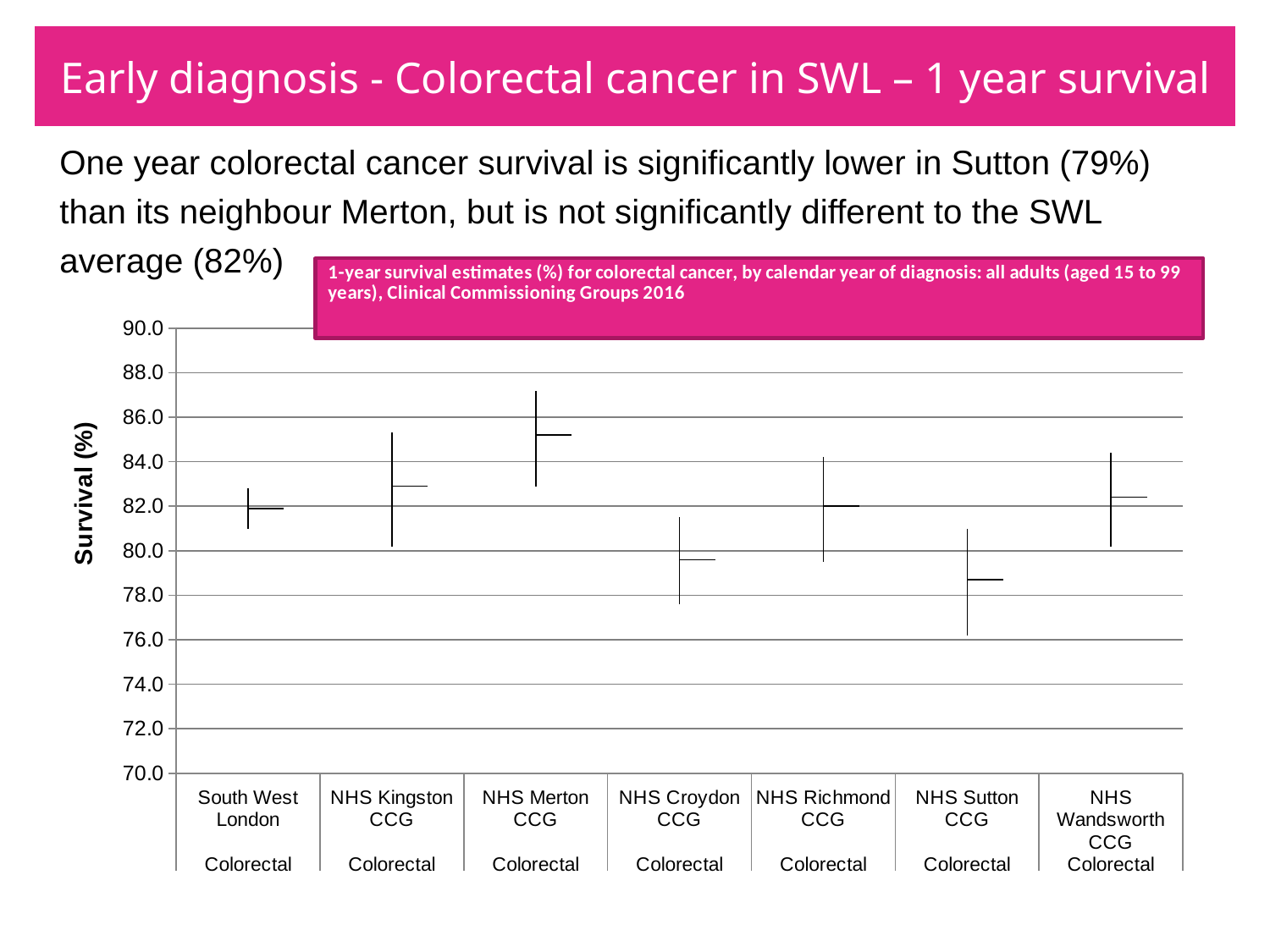
What is the label of the vertical axis of the chart? Survival (%) Which has the higher survival estimate, NHS Merton CCG or NHS Croydon CCG? NHS Merton CCG Which CCG has the lowest 1-year colorectal cancer survival estimate on the chart? NHS Sutton CCG Is the survival estimate for NHS Sutton CCG greater or less than 80.0? less Is the survival estimate for NHS Croydon CCG greater or less than 80.0? less Is the survival estimate for NHS Kingston CCG greater or less than 82.0? greater What is the lowest value shown on the vertical axis of the chart? 70.0 Which has the higher survival estimate, NHS Merton CCG or NHS Kingston CCG? NHS Merton CCG How many areas (categories) are plotted on the chart? 7 What kind of chart is shown on the slide? Error bar chart (point estimates with confidence intervals) Which CCG has the highest 1-year colorectal cancer survival estimate on the chart? NHS Merton CCG